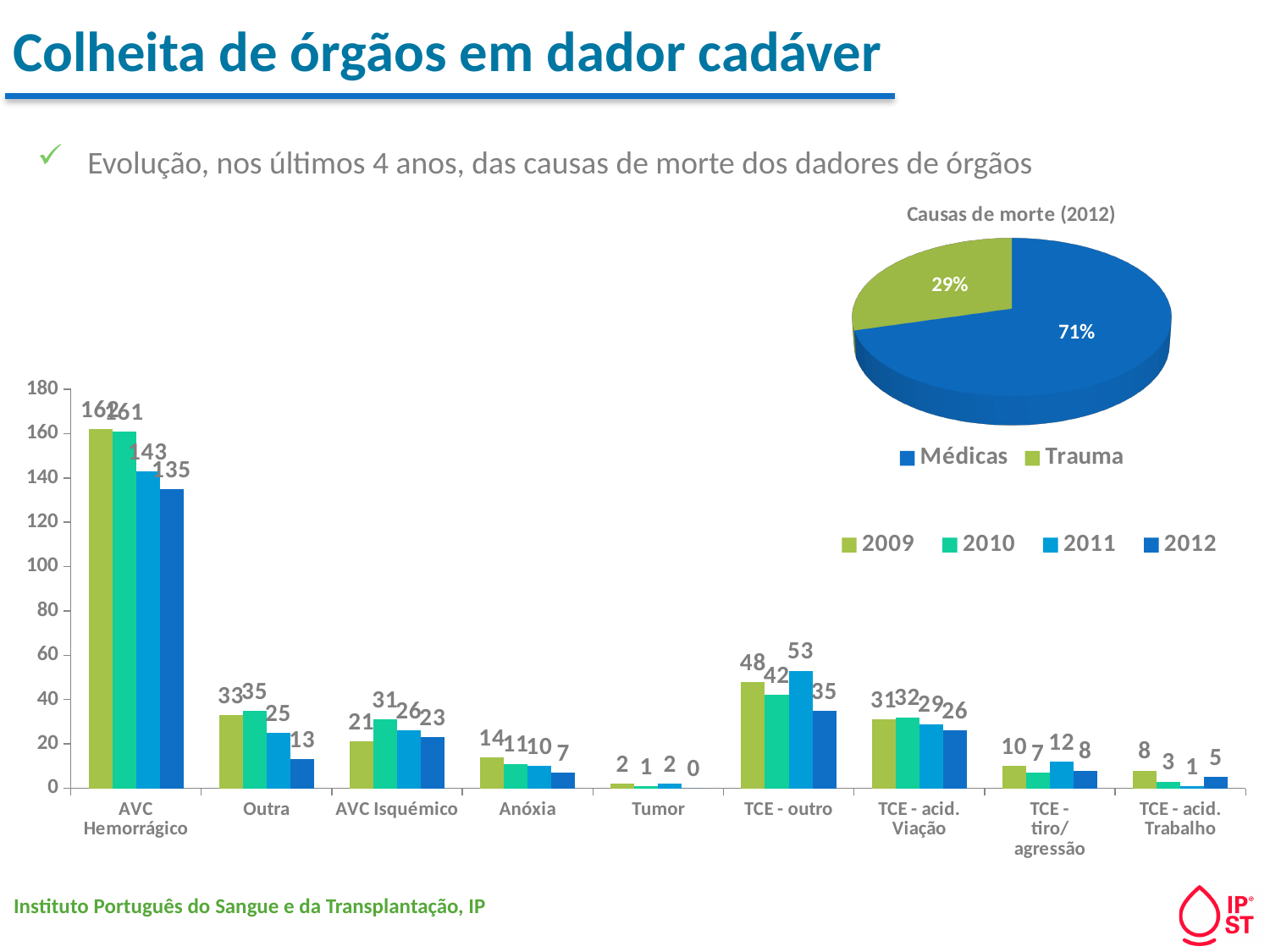
In the pie chart 'Causas de morte (2012)', what share is Trauma? 29% In the bar chart, which category has the highest value in 2009? AVC Hemorrágico In the bar chart, what was the value for Tumor in 2012? 0 In the bar chart, which category has the lowest value in 2010? Tumor In the bar chart, what was the value for TCE - outro in 2011? 53 In the bar chart, how many series does the legend list? 4 What type of chart is 'Causas de morte (2012)'? pie chart In the bar chart, which is larger for AVC Isquémico: the 2010 value or the 2011 value? 2010 In the bar chart, how many categories are shown on the x axis? 9 In the bar chart, what was the value for AVC Hemorrágico in 2012? 135 In the bar chart, what is the difference between the 2009 and 2012 values for Outra? 20 In the bar chart, do the values for AVC Hemorrágico rise or fall from 2009 to 2012? fall